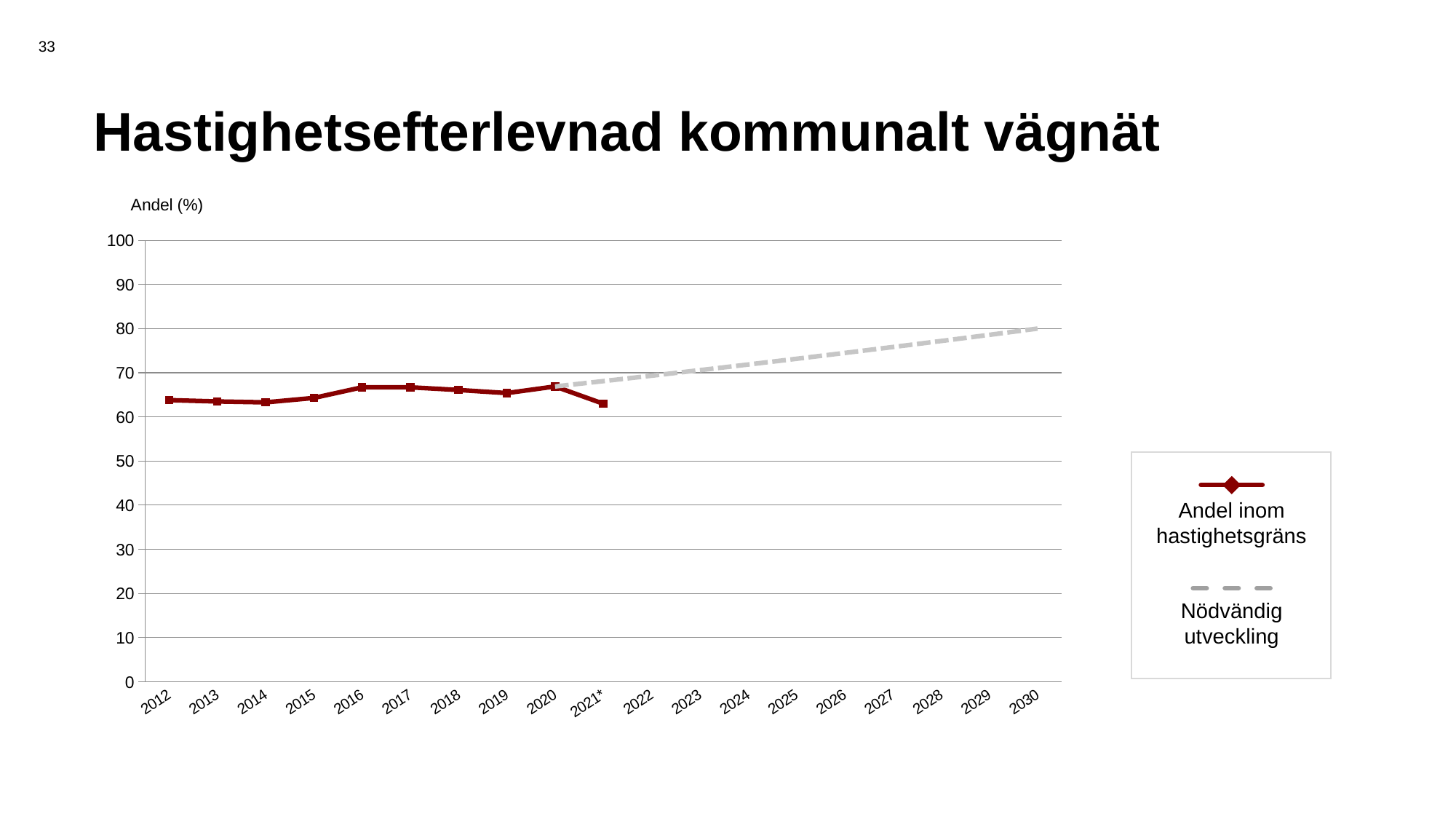
Is the value for 'Andel inom hastighetsgräns' in 2021* greater or less than 70? less Does the 'Nödvändig utveckling' line rise or fall from 2020 to 2030? rise Is the value for 'Andel inom hastighetsgräns' in 2012 greater or less than 60? greater Is the value of the 'Nödvändig utveckling' line in 2030 greater or less than 70? greater How many series does the legend list? 2 How many years are shown on the x axis? 19 Does the 'Andel inom hastighetsgräns' line rise or fall from 2020 to 2021*? fall What kind of chart is shown on the slide? line chart What is the label on the y axis? Andel (%) What is the title of the chart? Hastighetsefterlevnad kommunalt vägnät